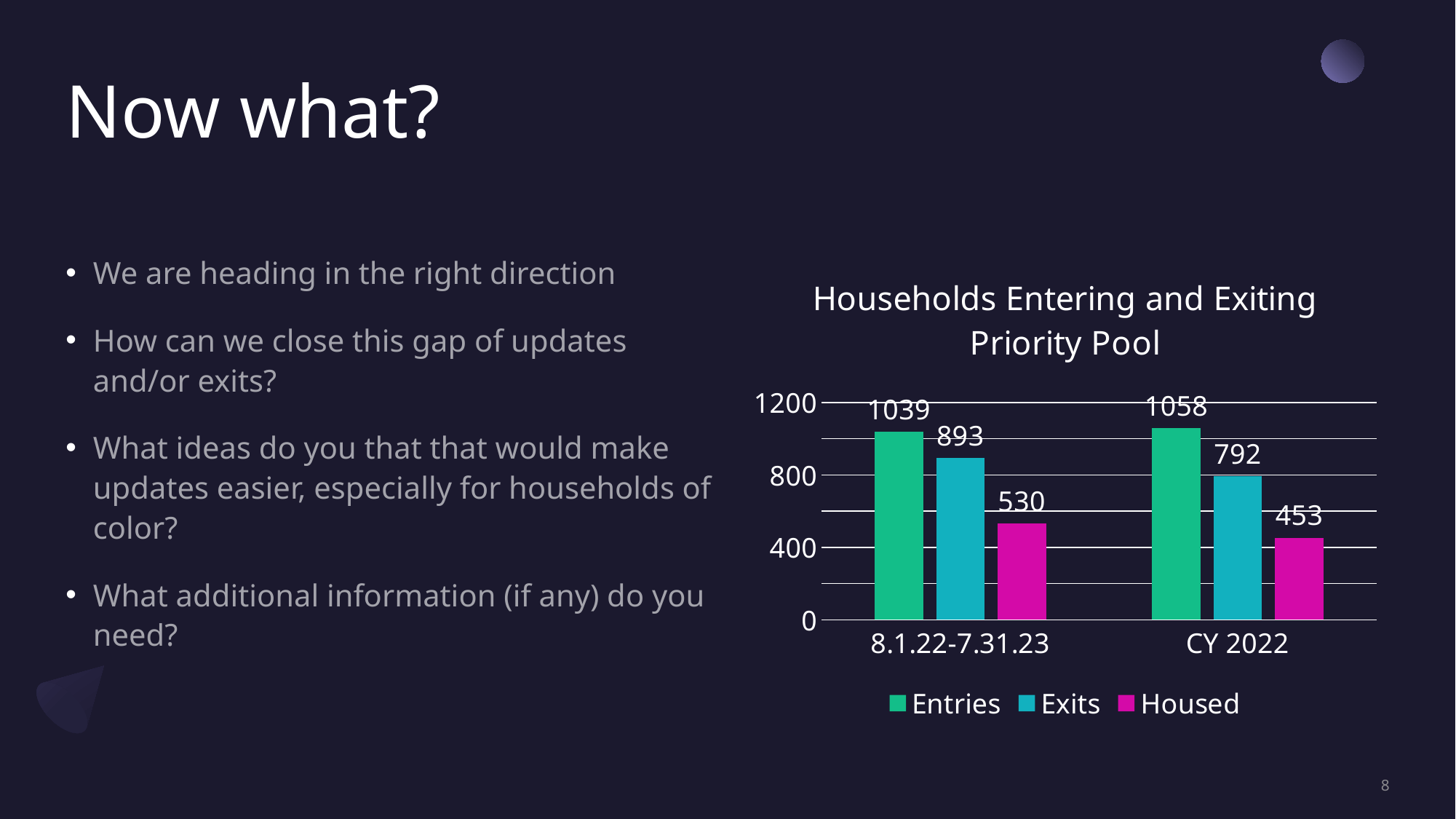
Which is larger: Exits in 8.1.22-7.31.23 or Exits in CY 2022? Exits in 8.1.22-7.31.23 Which series has the highest value in CY 2022? Entries What kind of chart is shown on the slide? Bar chart What is the difference between Entries and Exits in the 8.1.22-7.31.23 period? 146 What is the title of the chart? Households Entering and Exiting Priority Pool How many series does the legend list? 3 Which series has the lowest value in the 8.1.22-7.31.23 period? Housed What is the value for Housed in CY 2022? 453 What is the value for Exits in CY 2022? 792 What is the difference between Housed in 8.1.22-7.31.23 and Housed in CY 2022? 77 What is the value for Entries in the 8.1.22-7.31.23 period? 1039 What is the value for Housed in the 8.1.22-7.31.23 period? 530